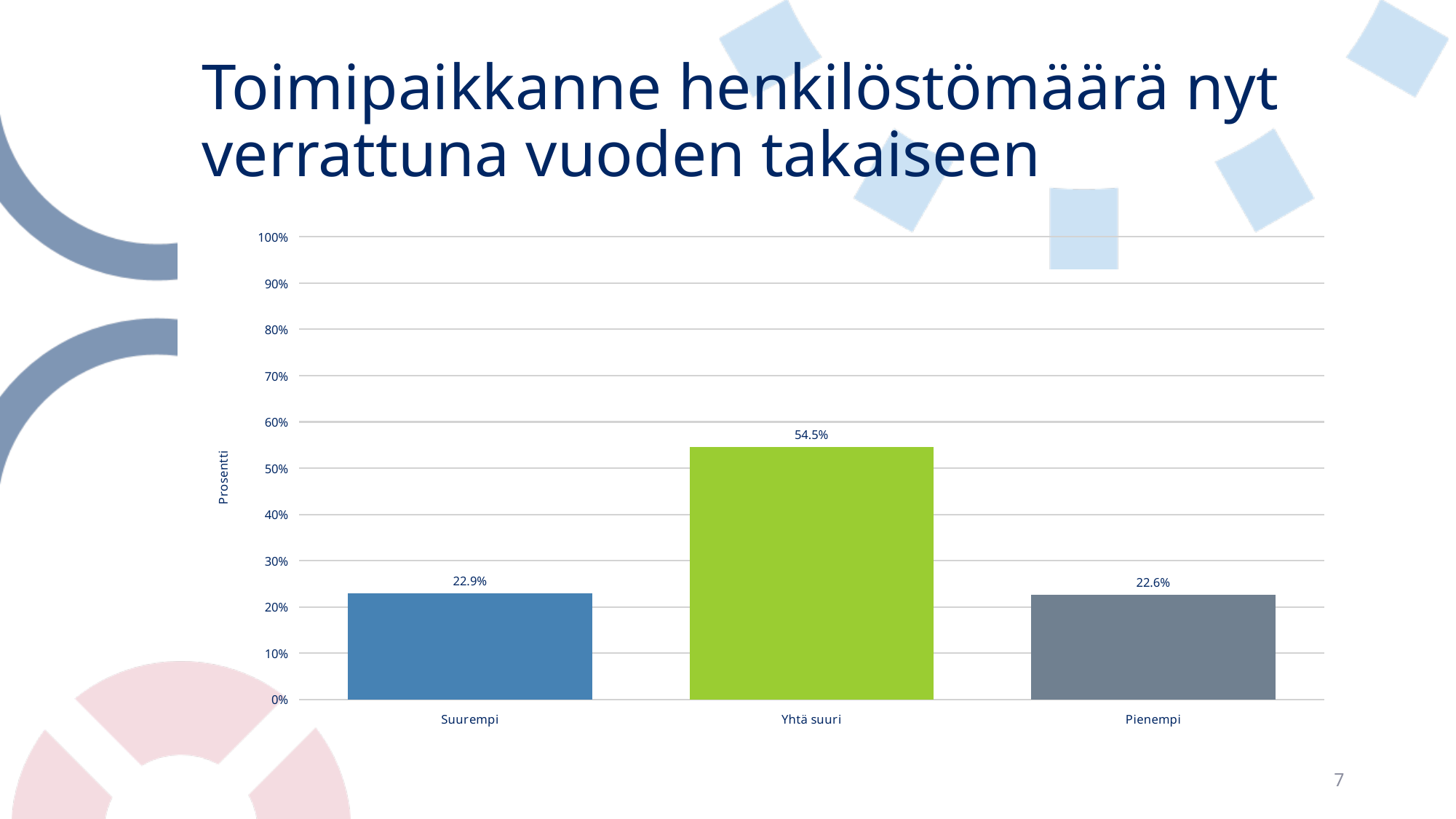
What is the value for Suurempi? 22.9% Which category has the highest value? Yhtä suuri How many categories are shown on the x axis? 3 Is the value for Pienempi greater or less than 30%? less What is the label of the vertical axis? Prosentti What is the value for Yhtä suuri? 54.5% Is the value for Yhtä suuri greater or less than 50%? greater What kind of chart is shown on the slide? bar chart What is the difference between the values for Yhtä suuri and Suurempi? 31.6% What is the difference between the values for Suurempi and Pienempi? 0.3% Which is larger, the value for Yhtä suuri or the value for Pienempi? Yhtä suuri What is the value for Pienempi? 22.6%